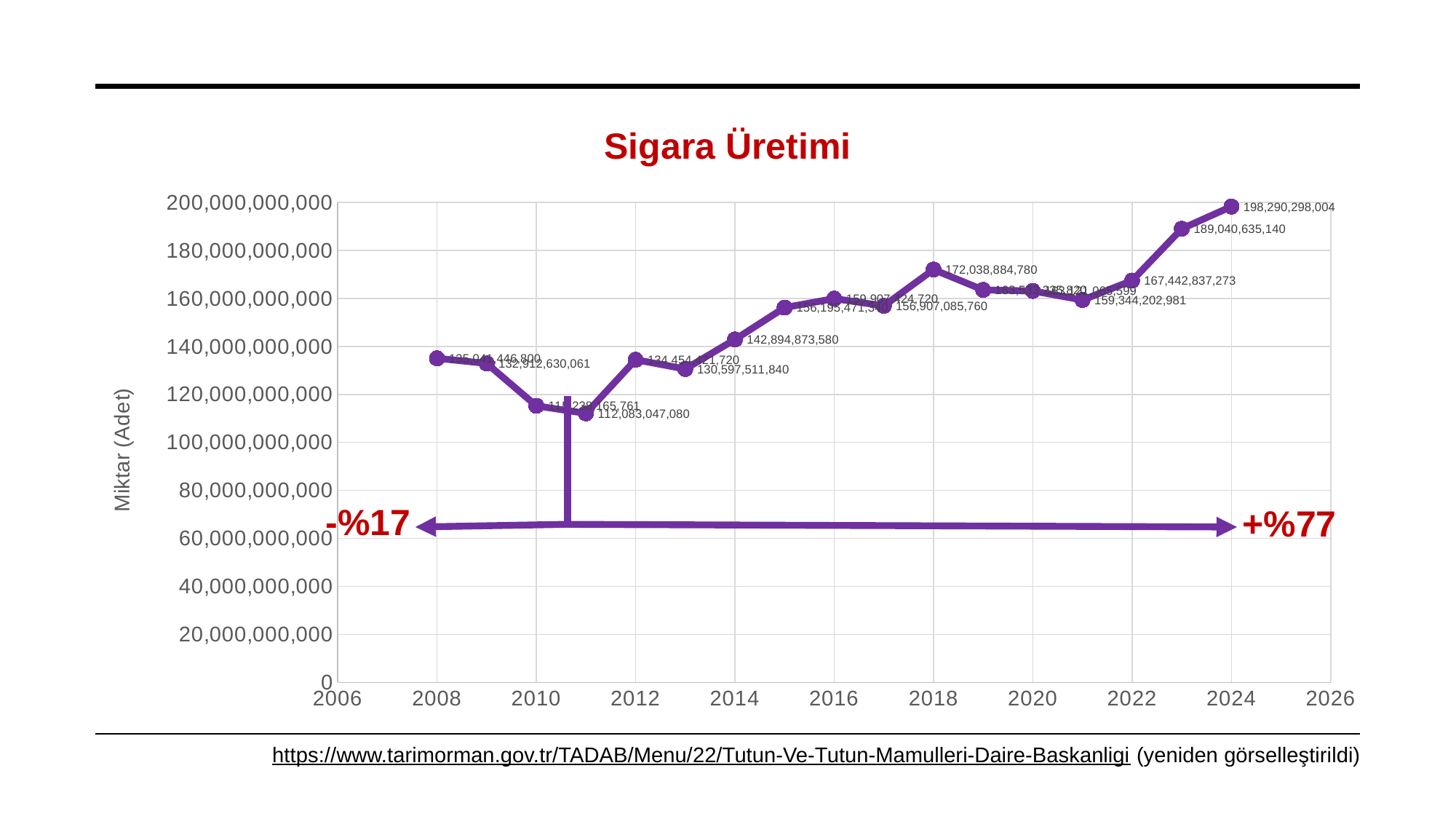
Which year has the lowest value in the Sigara Üretimi chart? 2011 What kind of chart is the Sigara Üretimi chart? line chart How many data points are plotted in the Sigara Üretimi chart? 17 What is the value for 2011 in the Sigara Üretimi chart? 112,083,047,080 What is the value for 2023 in the Sigara Üretimi chart? 189,040,635,140 What is the value for 2024 in the Sigara Üretimi chart? 198,290,298,004 Which year has the highest value in the Sigara Üretimi chart? 2024 Is the value for 2010 in the Sigara Üretimi chart greater or less than 120,000,000,000? less What is the value for 2018 in the Sigara Üretimi chart? 172,038,884,780 What is the value for 2014 in the Sigara Üretimi chart? 142,894,873,580 What is the difference between the 2024 and 2023 values in the Sigara Üretimi chart? 9,249,662,864 Which is larger in the Sigara Üretimi chart, the value for 2018 or the value for 2022? 2018